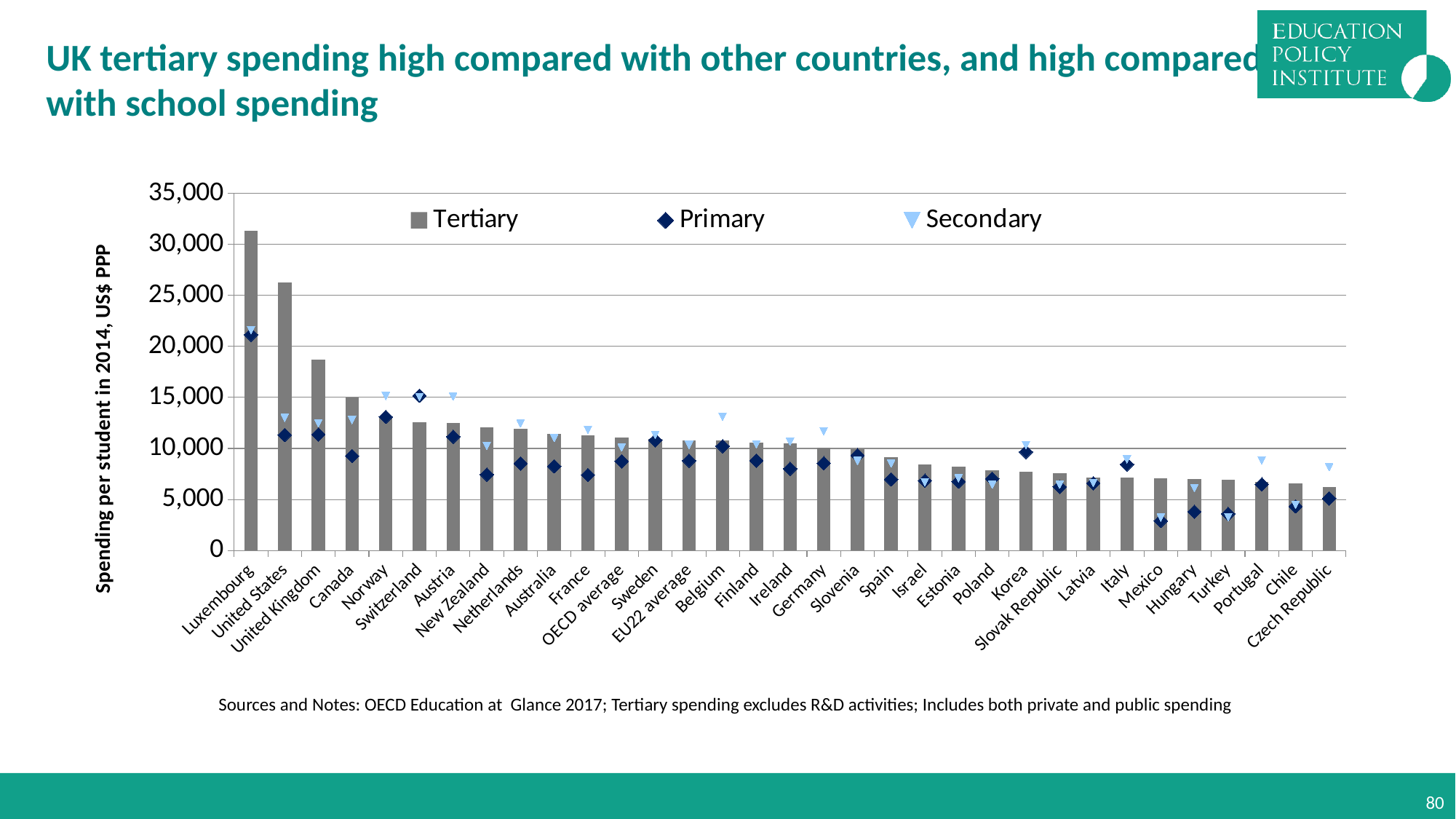
How many series does the legend list? 3 Which country has the lowest Primary spending per student? Mexico Is the Tertiary value for Luxembourg greater or less than 30,000? greater What kind of chart is shown on the slide? bar chart Which country has the highest Tertiary spending per student? Luxembourg Is the Primary value for Mexico greater or less than 5,000? less Is the Tertiary value for the United States greater or less than 25,000? greater What is the title of the vertical axis? Spending per student in 2014, US$ PPP How many countries or averages are shown along the x axis? 33 Do the Tertiary bars rise or fall from left to right along the x axis? fall Which has the larger Tertiary spending, the United Kingdom or Canada? United Kingdom